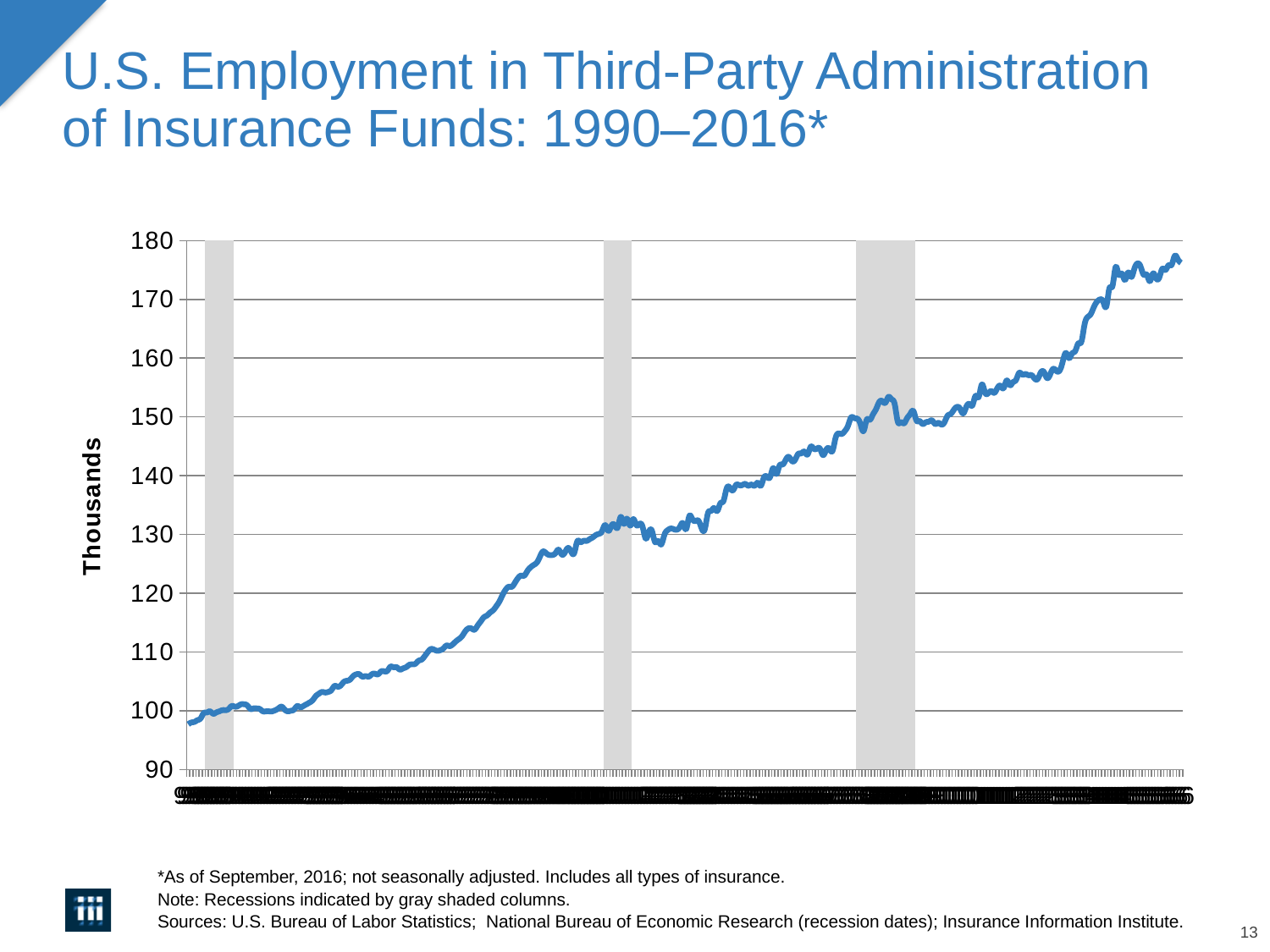
What is the label on the vertical axis? Thousands Do the values generally rise or fall from left to right along the x axis? rise How many gray shaded columns (recessions) are shown on the chart? 3 Is the highest point on the line greater or less than 180? less Is the value at the start of the series (left end of the line) greater or less than 110? less Is the value at the end of the series greater or less than the value at the start of the series? greater Is the lowest point on the line greater or less than 90? greater What kind of chart is shown on the slide? line chart